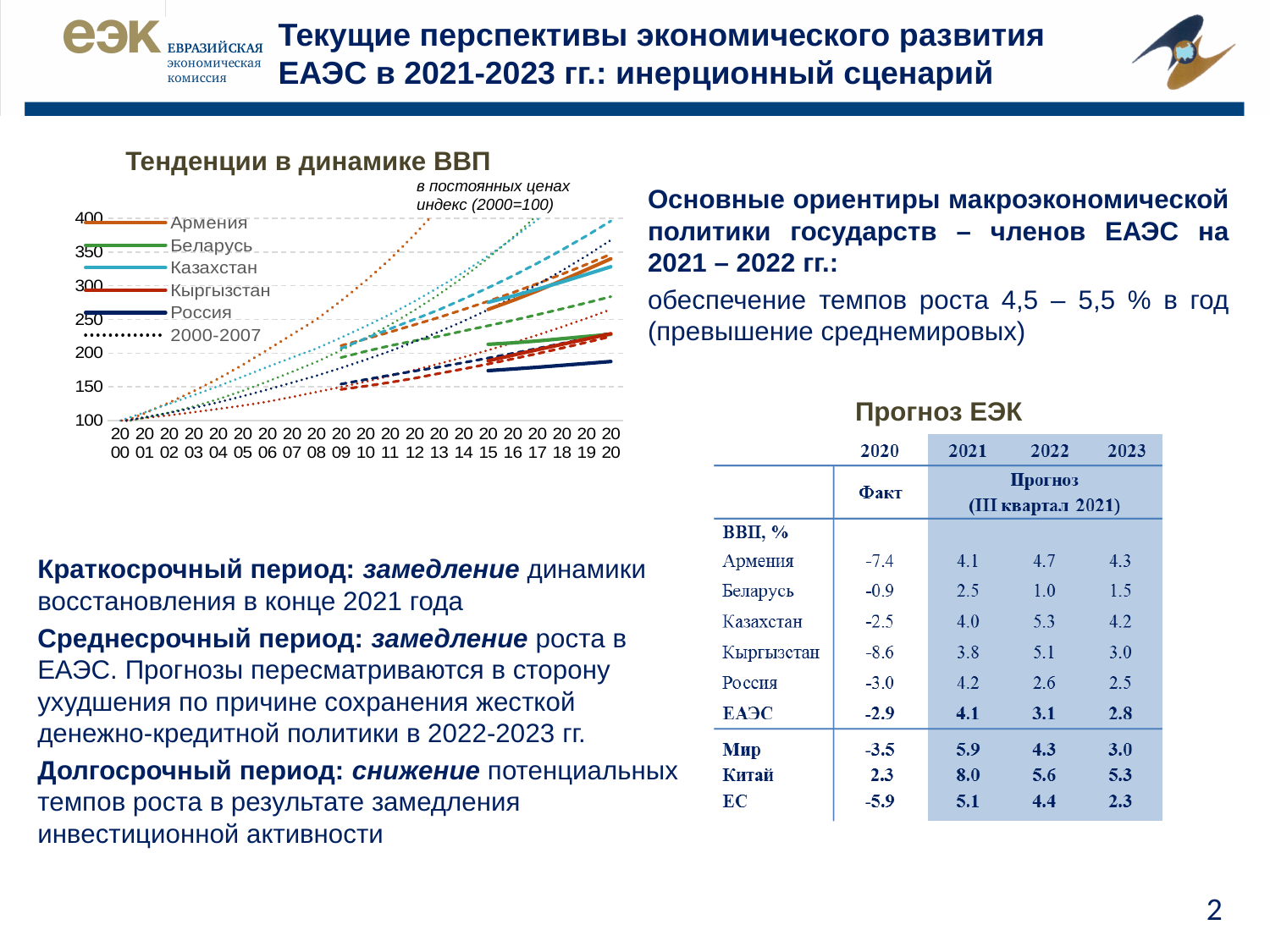
How many entries does the legend of the 'Тенденции в динамике ВВП' chart list? 6 What is the title of the chart on the slide? Тенденции в динамике ВВП In the 'Тенденции в динамике ВВП' chart, which solid line is higher in 2020: Армения or Россия? Армения In the 'Тенденции в динамике ВВП' chart, is the solid-line value for Армения in 2020 greater or less than 300? greater In the 'Тенденции в динамике ВВП' chart, do the GDP index lines rise or fall from 2000 to 2020? rise What is the highest value shown on the y axis of the 'Тенденции в динамике ВВП' chart? 400 In the 'Тенденции в динамике ВВП' chart, is the solid-line value for Казахстан in 2020 greater or less than 300? greater How many years are labelled on the x axis of the 'Тенденции в динамике ВВП' chart? 21 In the 'Тенденции в динамике ВВП' chart, what is the index value for all countries in 2000? 100 What kind of chart is 'Тенденции в динамике ВВП'? line chart In the 'Тенденции в динамике ВВП' chart, is the solid-line value for Россия in 2020 greater or less than 200? less In the 'Тенденции в динамике ВВП' chart, which solid line is lowest in 2020? Россия